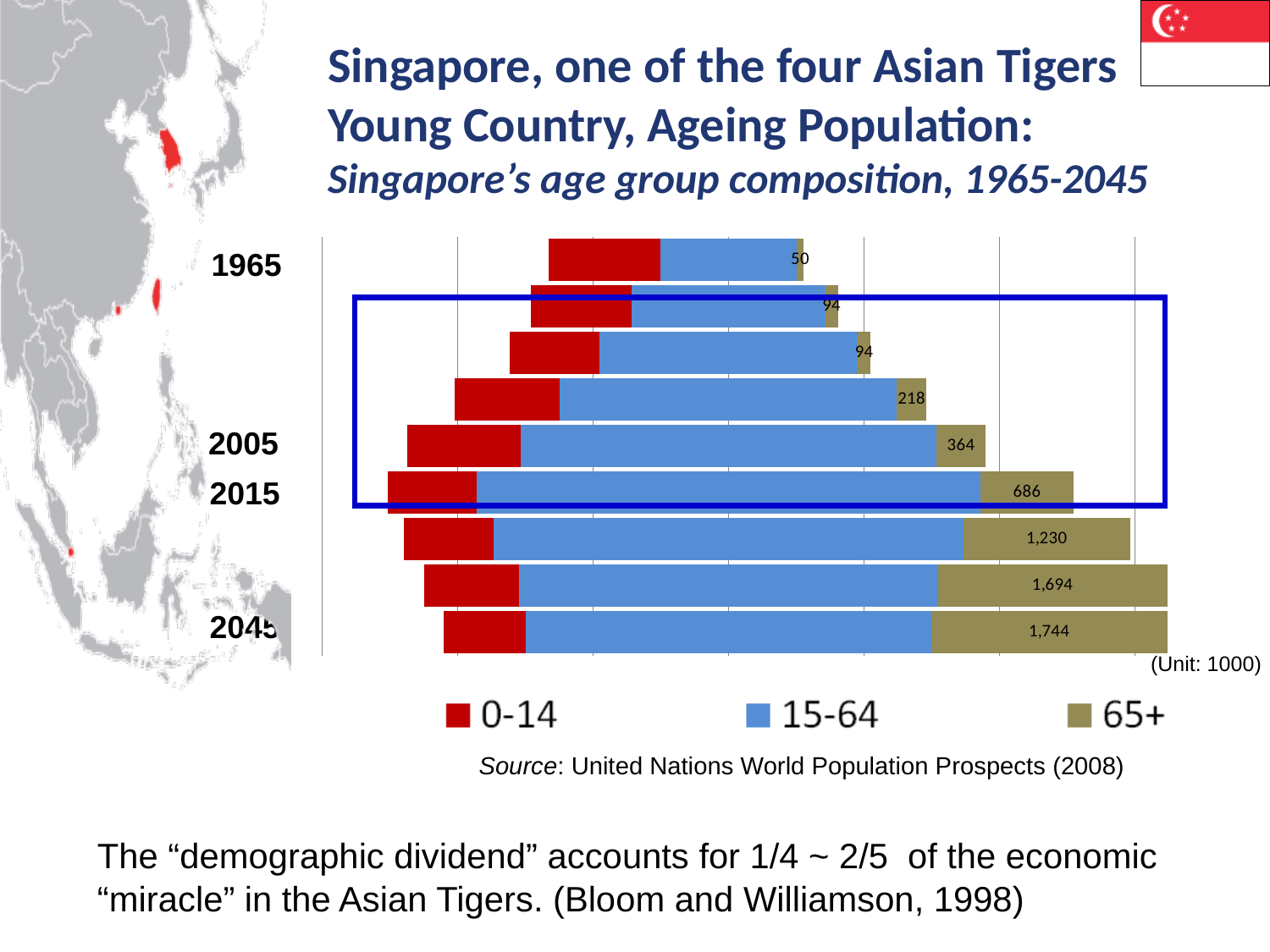
What is the value of the 65+ age group for 2045? 1,744 Which is larger, the 65+ value for 2045 or for 2015? 2045 Which year has the highest labelled value for the 65+ age group? 2045 What kind of chart is shown on the slide? Stacked bar chart How many series does the chart legend list? 3 What is the difference between the 65+ values for 2015 and 2005? 322 What is the value of the 65+ age group for 1965? 50 What is the value of the 65+ age group for 2015? 686 What is the value of the 65+ age group for 2005? 364 Which year has the lowest labelled value for the 65+ age group? 1965 What are the three age groups listed in the chart legend? 0-14, 15-64, 65+ Does the 65+ age group value rise or fall from 1965 to 2045? Rise